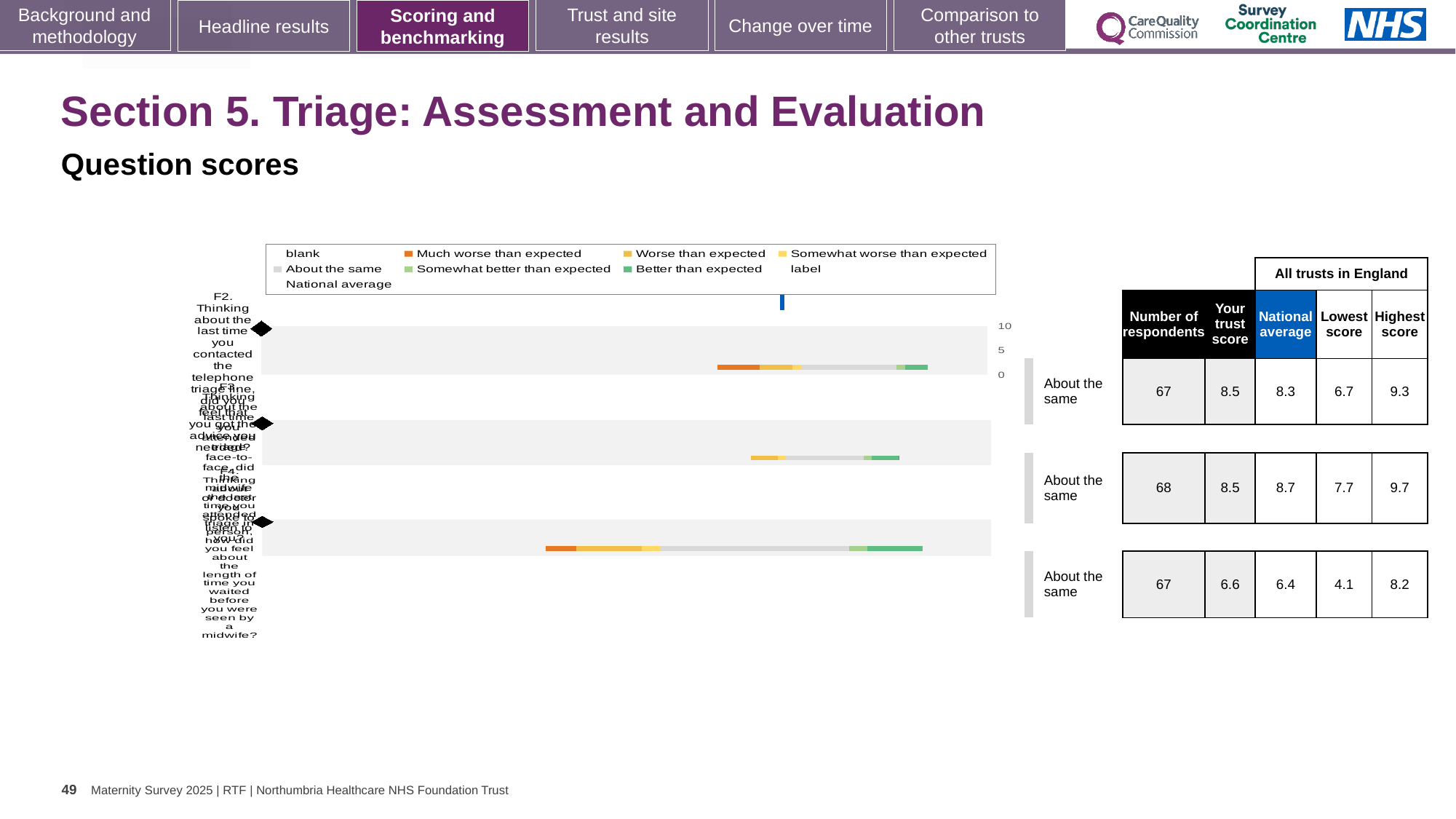
How many questions (F2, F3, F4) are plotted in the chart? 3 For question F3 (the second row), which is larger: the trust score or the national average? National average What is the difference between the highest score and the lowest score for question F4 (the third row)? 4.1 What is the national average for question F4 (the third row)? 6.4 What benchmark category is shown for all three questions? About the same What colour does the legend use for 'Much worse than expected'? Orange How many respondents are listed for question F3 (the second row)? 68 By how much does the trust score for question F2 (the first row) exceed the national average? 0.2 What is the 'Your trust score' for question F2 (the first row)? 8.5 What is the highest score among all trusts in England for question F3 (the second row)? 9.7 What kind of chart is shown on the slide? bar chart Which question has the lowest 'Your trust score'? F4